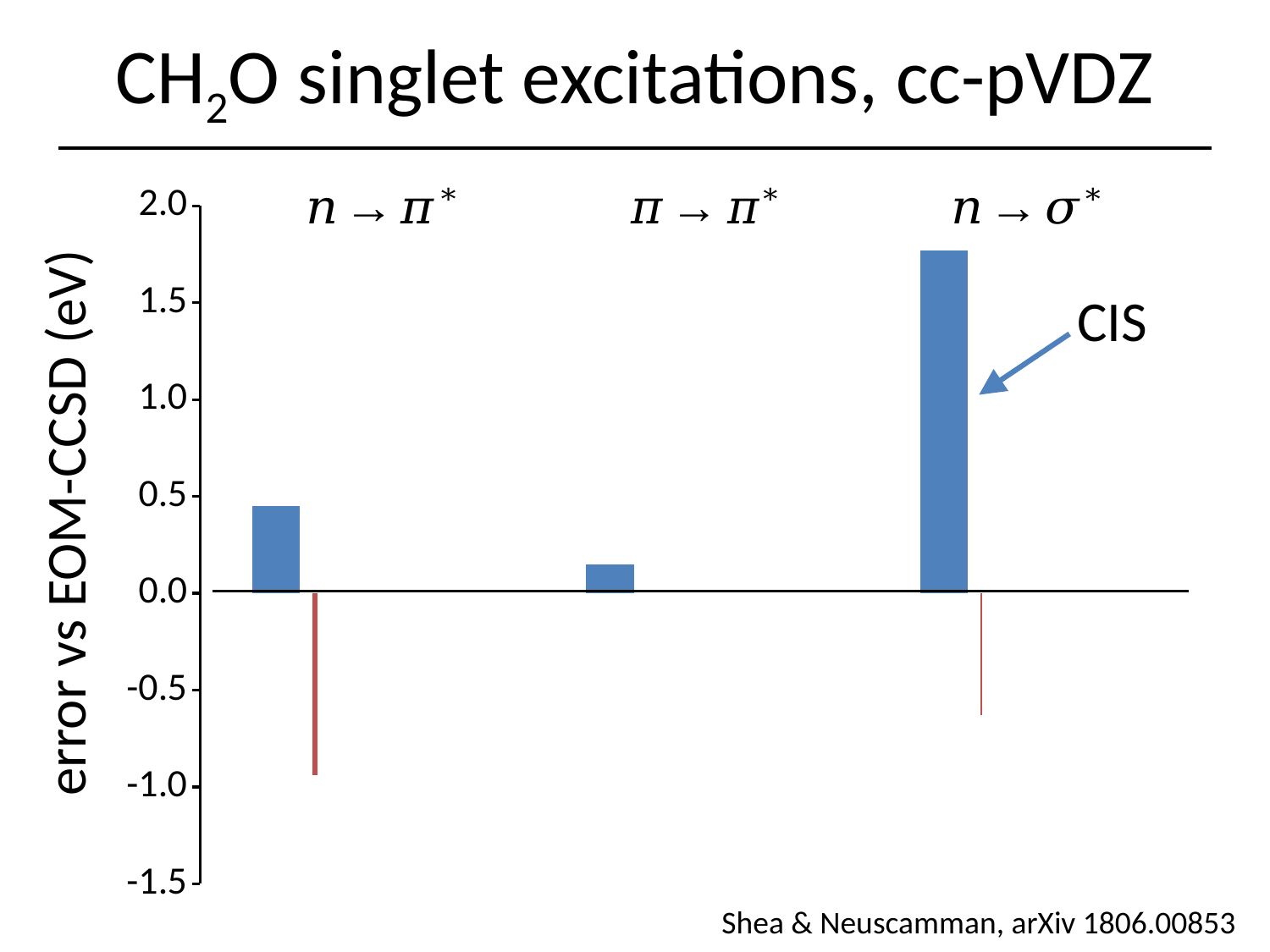
What kind of chart is shown on the slide? bar chart What is the label of the y axis? error vs EOM-CCSD (eV) Is the CIS error for n → σ* greater or less than 1.5 eV? greater Which excitation has the largest CIS error (tallest blue bar)? n → σ* How many excitation categories are shown along the x axis? 3 Which has the larger CIS error, n → π* or π → π*? n → π* Is the red-line value for n → π* greater or less than -0.5 eV? less Which excitation has the smallest CIS error (shortest blue bar)? π → π* Which method do the blue bars represent, according to the arrow annotation? CIS Is the CIS error for π → π* greater or less than 0.5 eV? less